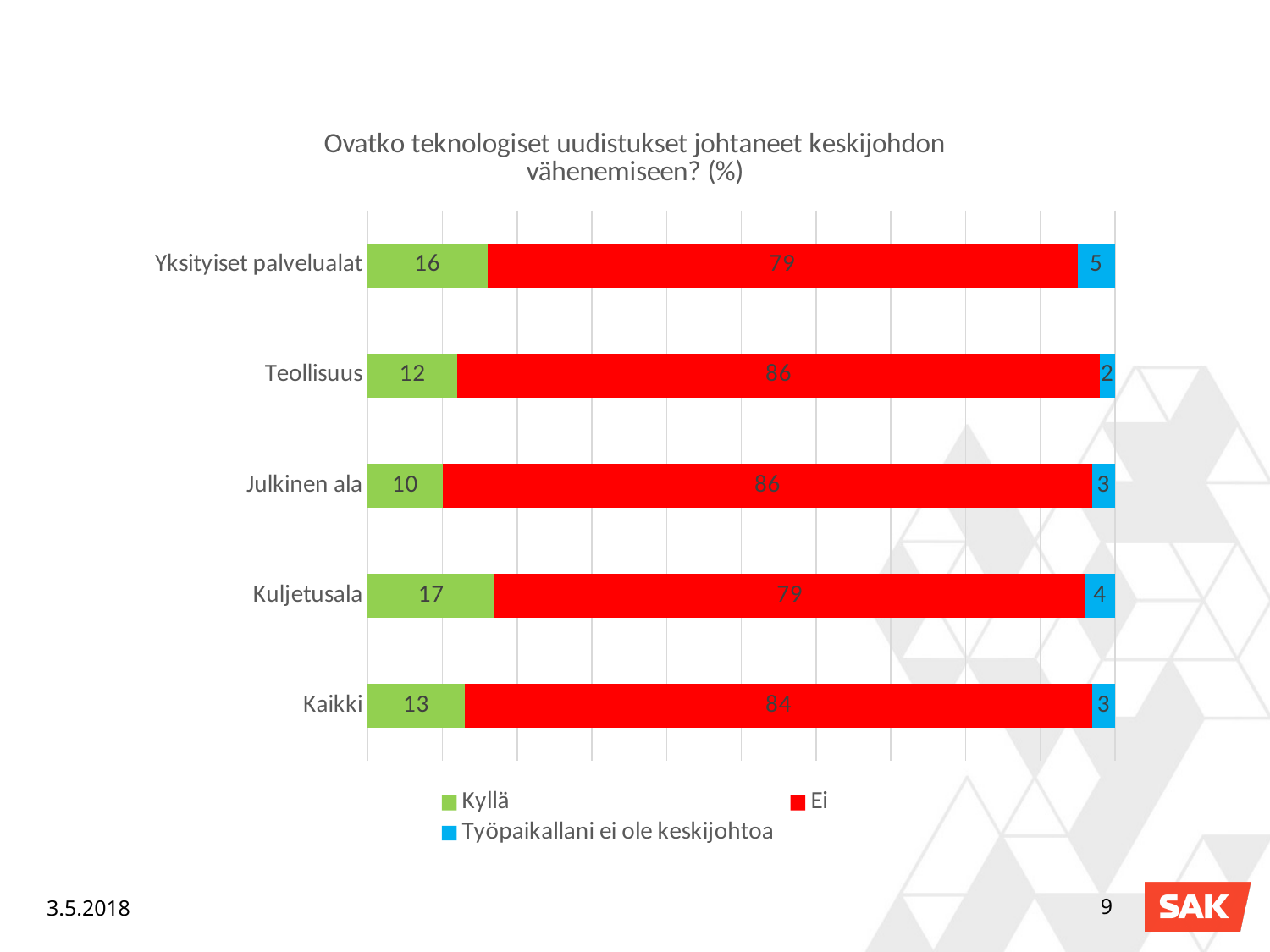
Which is larger, the Kyllä value for Yksityiset palvelualat or for Teollisuus? Yksityiset palvelualat How many categories are shown on the chart? 5 What is the value for Ei for Kaikki? 84 Which category has the highest Kyllä value? Kuljetusala What is the difference between the Ei values for Teollisuus and Yksityiset palvelualat? 7 Which category has the lowest Kyllä value? Julkinen ala What is the value for Kyllä for Kuljetusala? 17 What colour represents the Ei series? Red What kind of chart is shown on the slide? Stacked bar chart What is the total of the stacked bar for Kaikki? 100 How many series does the legend list? 3 What is the value for Työpaikallani ei ole keskijohtoa for Yksityiset palvelualat? 5